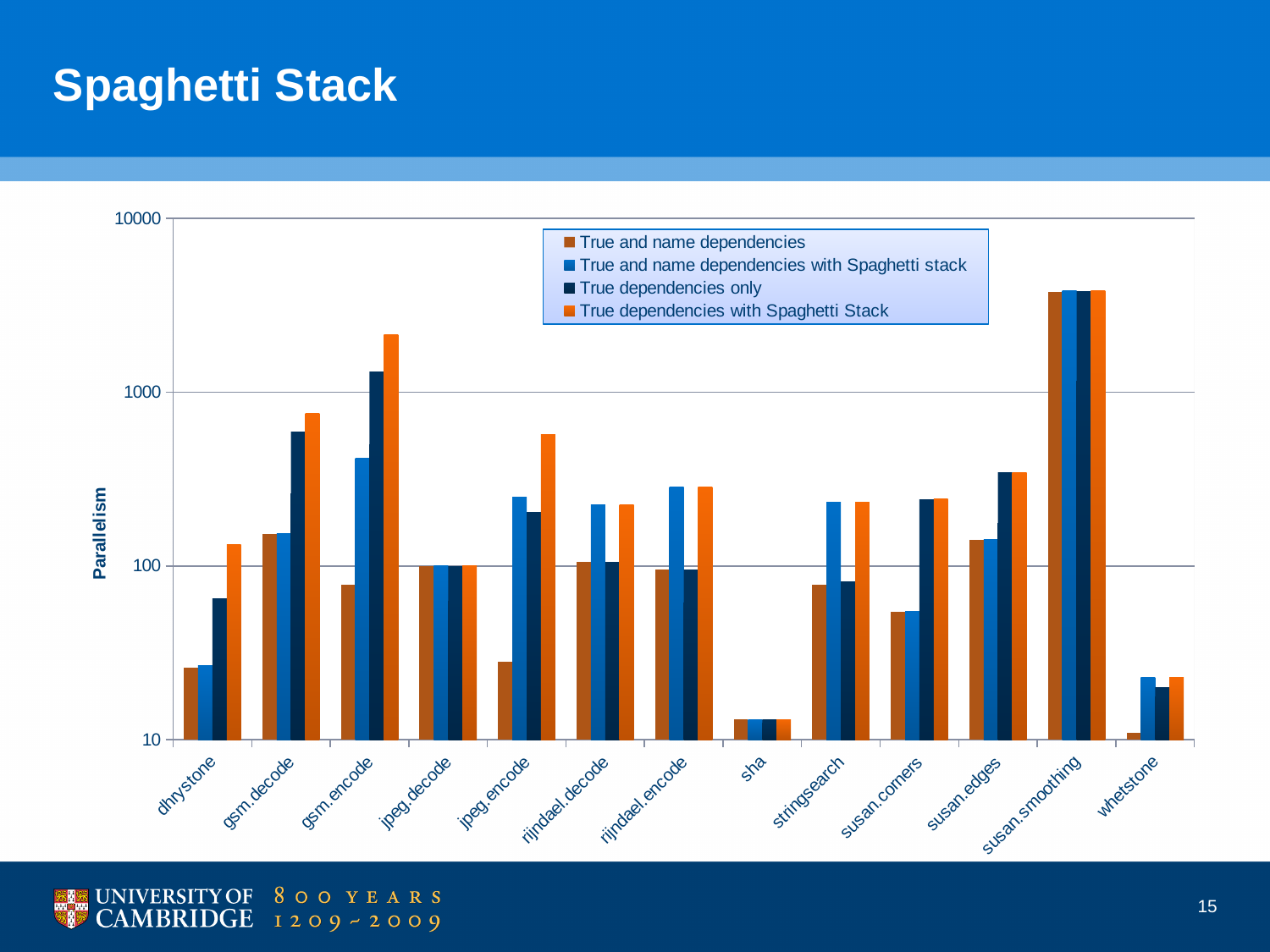
What kind of chart is shown on the slide? bar chart Which benchmark has the highest parallelism for the 'True dependencies with Spaghetti Stack' series? susan.smoothing Is the 'True and name dependencies' value for dhrystone greater or less than 100? less Which benchmark has the lowest parallelism for the 'True dependencies with Spaghetti Stack' series? sha Is the 'True dependencies only' value for susan.smoothing greater or less than 1000? greater For the 'True and name dependencies' series, which is larger: gsm.decode or jpeg.encode? gsm.decode Is the 'True dependencies with Spaghetti Stack' value for gsm.encode greater or less than 1000? greater How many benchmark categories are shown along the x axis? 13 For the 'True dependencies with Spaghetti Stack' series, which is larger: gsm.encode or gsm.decode? gsm.encode What is the label on the y axis of the chart? Parallelism How many series does the legend list? 4